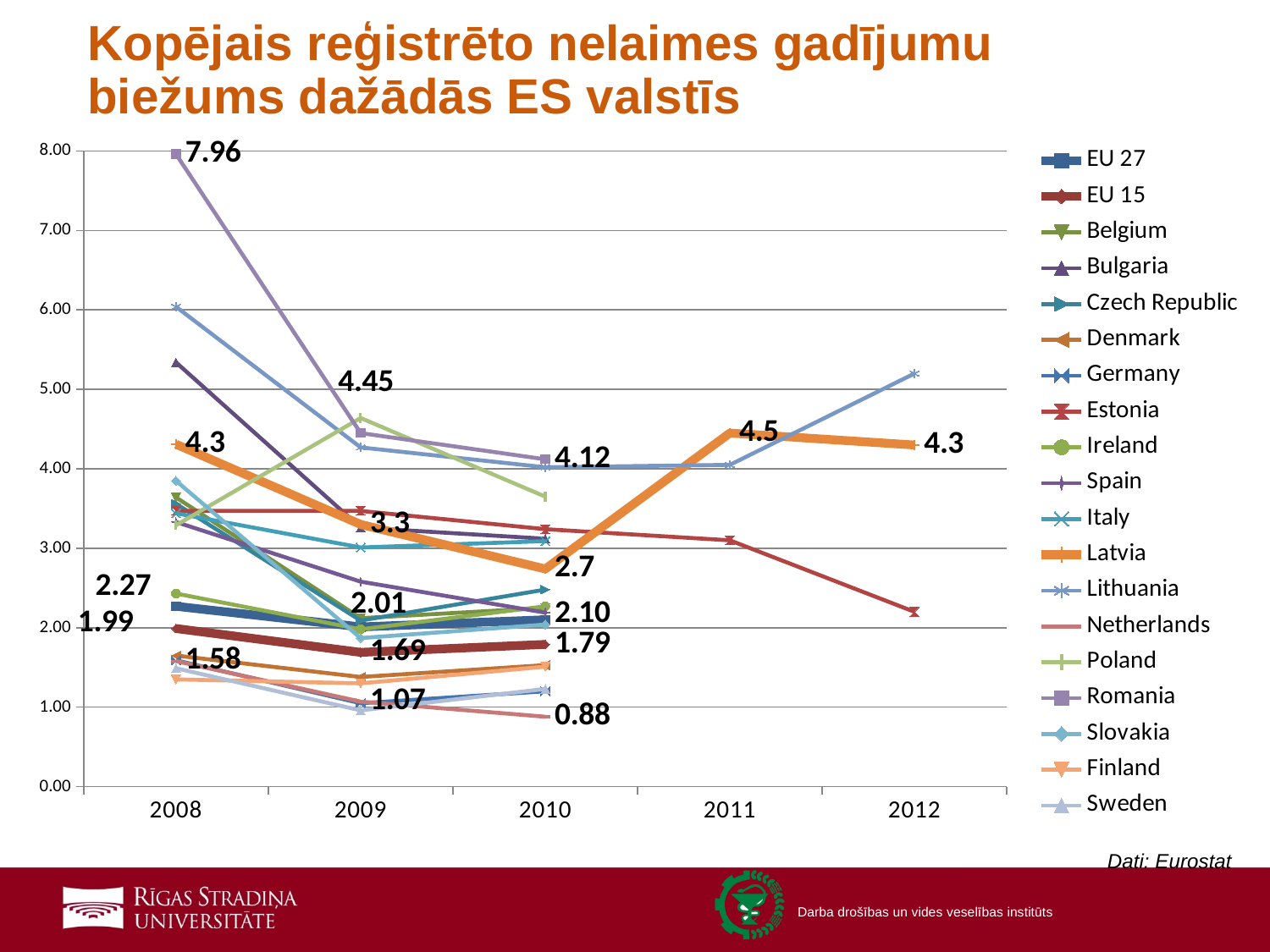
What kind of chart is shown on the slide? line chart Which is larger in 2010, the value for EU 27 or the value for EU 15? EU 27 How many series does the legend list? 19 What is the value for Latvia in 2011? 4.5 How many years are shown on the x axis? 5 What is the value for EU 15 in 2010? 1.79 What is the difference between Latvia's value in 2011 and its value in 2010? 1.8 Is the value for Lithuania in 2012 greater or less than 5.00? greater What is the value for EU 27 in 2009? 2.01 Which series has the highest value in 2008? Romania What is the value for Romania in 2008? 7.96 Does the value for Latvia rise or fall from 2008 to 2010? fall